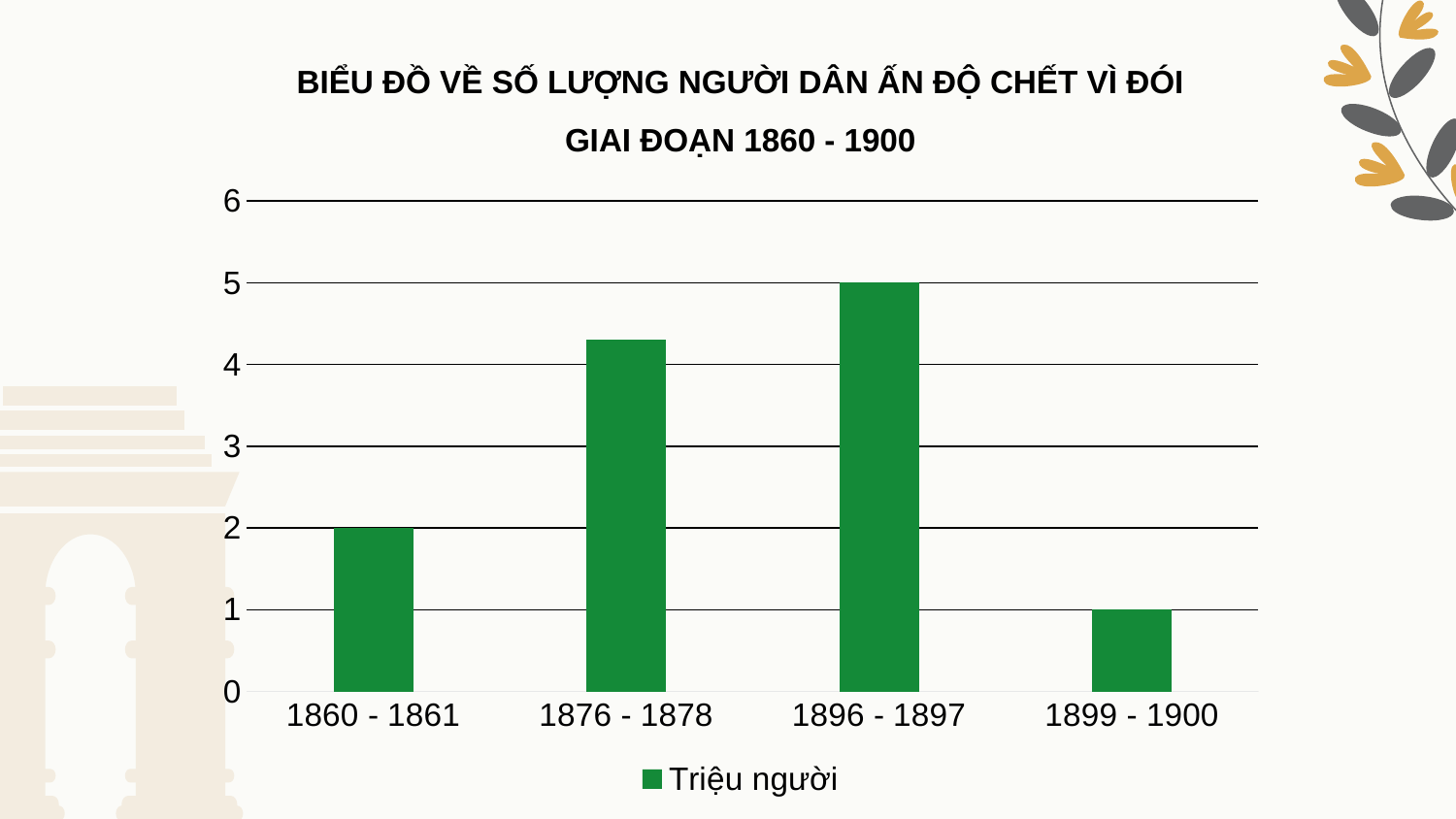
How many periods are shown on the x axis? 4 What is the legend entry for the series? Triệu người What is the value for 1896 - 1897? 5 Which period has the highest value? 1896 - 1897 What is the difference between the values for 1896 - 1897 and 1860 - 1861? 3 What kind of chart is shown on the slide? bar chart What is the value for 1899 - 1900? 1 How many series does the legend list? 1 Which period has the lowest value? 1899 - 1900 Which is larger, the value for 1876 - 1878 or the value for 1860 - 1861? 1876 - 1878 What is the value for 1860 - 1861? 2 Is the value for 1876 - 1878 greater or less than 4? greater